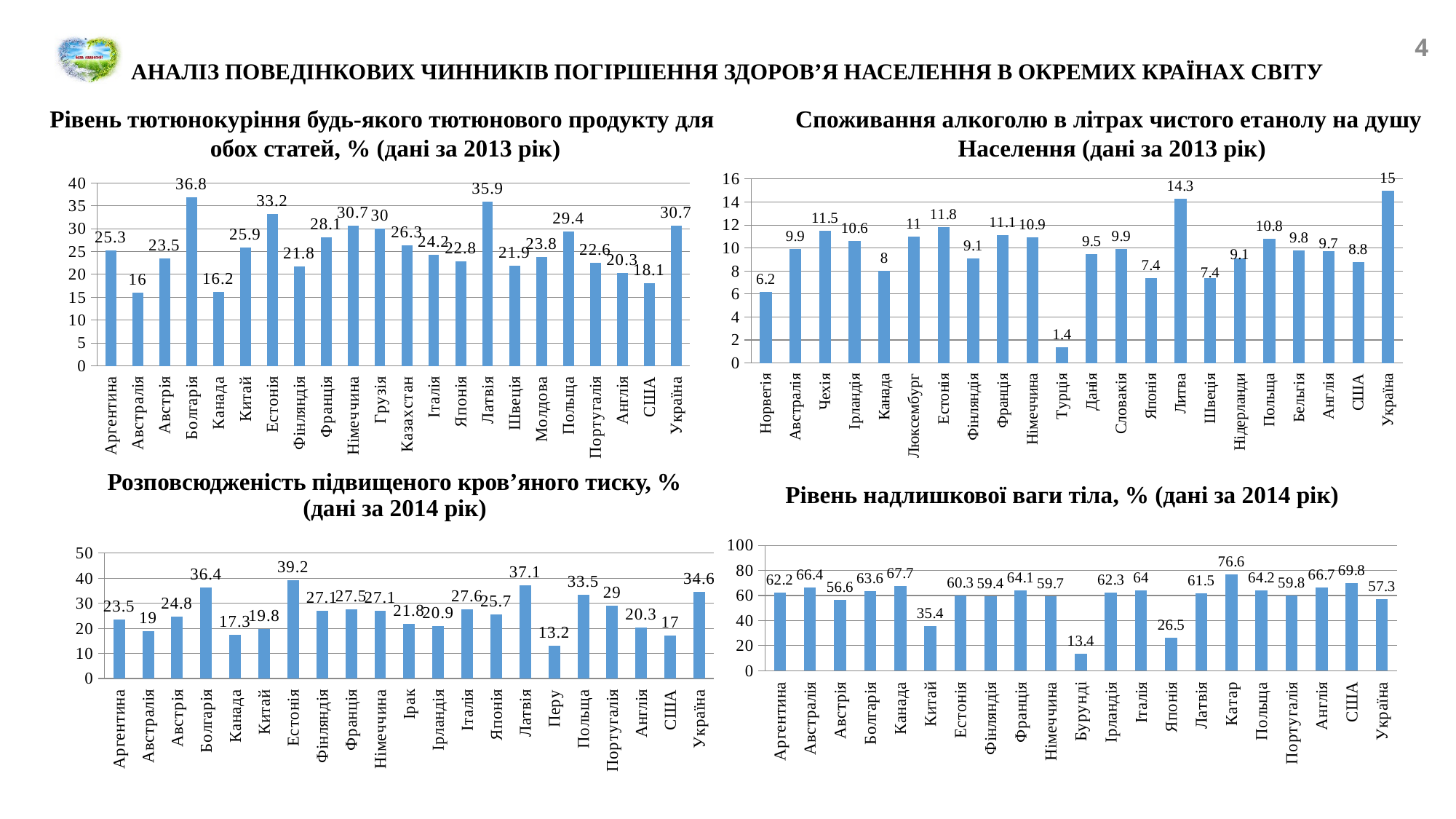
How many countries are shown in the overweight chart (bottom-right)? 21 In the alcohol consumption chart (top-right), what is the difference between Литва and Норвегія? 8.1 In the blood pressure chart (bottom-left), which is larger, Латвія or Болгарія? Латвія What type of chart is the alcohol consumption chart (top-right)? Bar chart In the alcohol consumption chart (top-right), which country has the lowest value? Турція In the smoking chart (top-left), what is the value for Болгарія? 36.8 In the blood pressure chart (bottom-left), which country has the highest value? Естонія In the alcohol consumption chart (top-right), what is the value for Україна? 15 In the smoking chart (top-left), which country has the lowest value? Австралія In the overweight chart (bottom-right), what is the value for Катар? 76.6 In the overweight chart (bottom-right), which country has the lowest value? Бурунді In the blood pressure chart (bottom-left), what is the value for Перу? 13.2